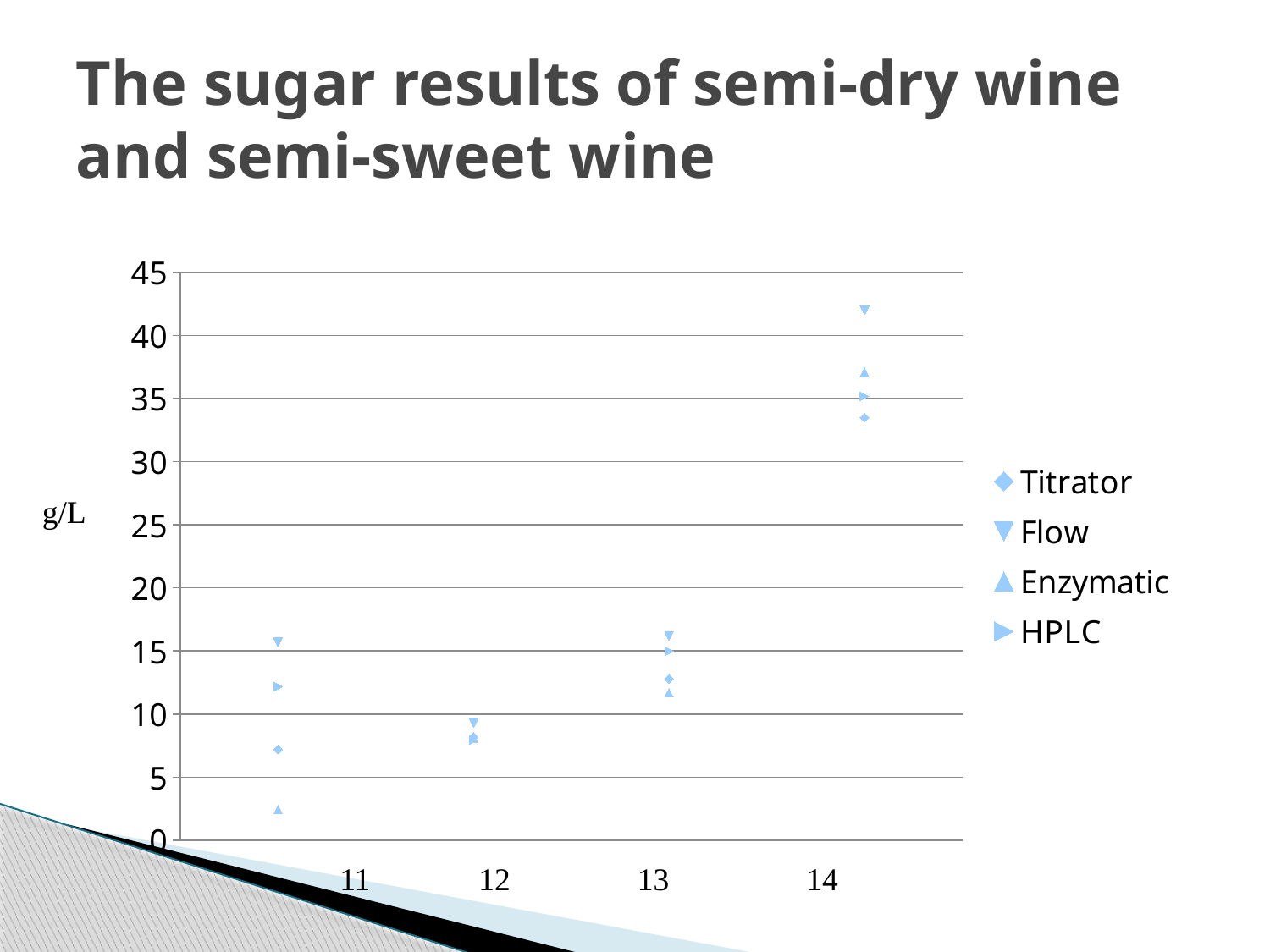
Which sample has the highest Flow value? 14 Which sample has the lowest Enzymatic value? 11 Is the HPLC value for sample 11 greater or less than 10? greater For sample 11, which is larger, the Flow value or the Titrator value? Flow Is the Flow value for sample 14 greater or less than 40? greater What unit is shown on the y axis of the chart? g/L How many series does the legend list? 4 Is the Titrator value for sample 14 greater or less than 30? greater For sample 14, which is larger, the Flow value or the Titrator value? Flow What kind of chart is shown on the slide? scatter chart How many sample numbers are shown along the x axis? 4